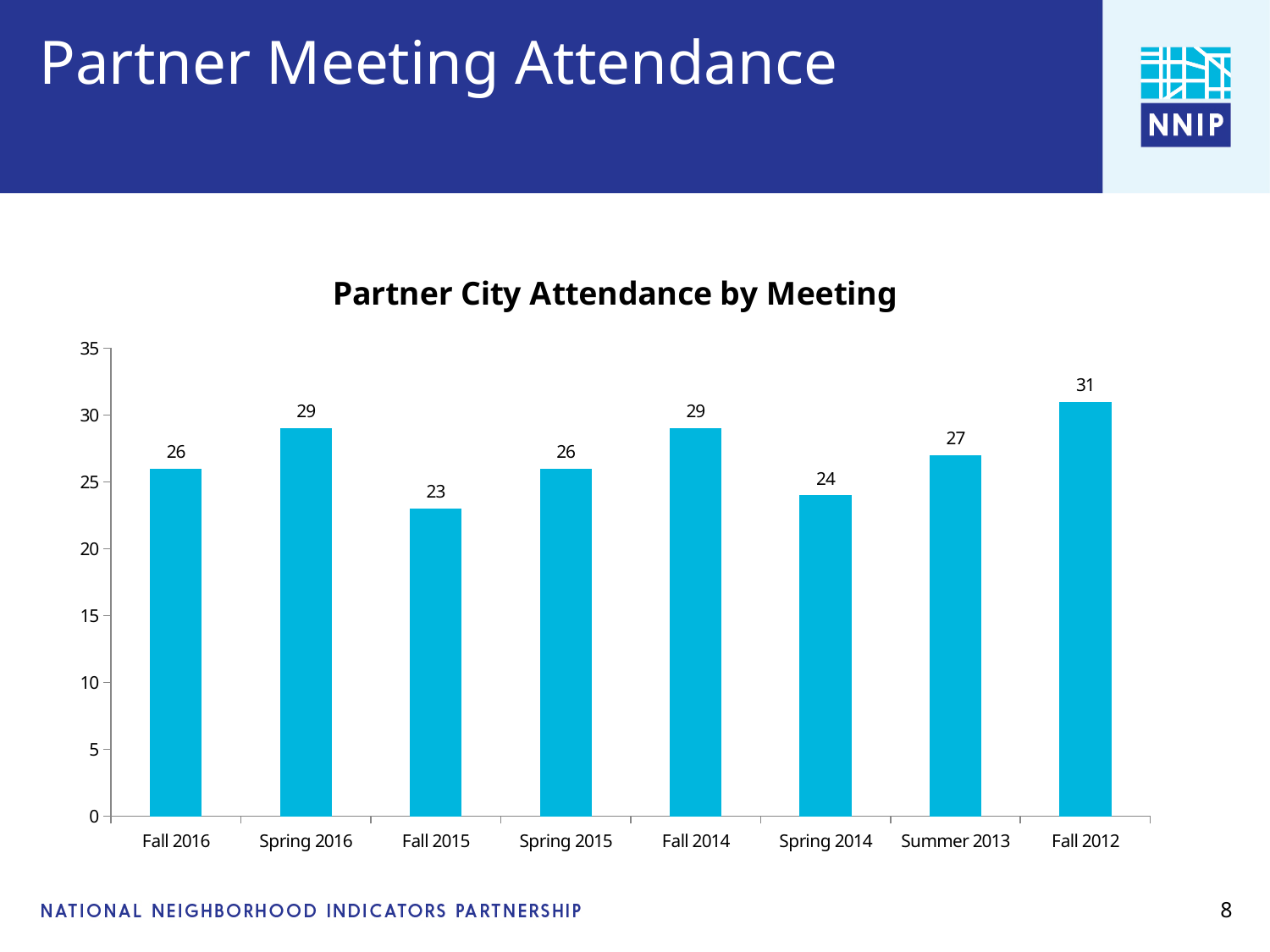
Which meeting has the lowest partner city attendance? Fall 2015 Which has higher attendance, Fall 2014 or Summer 2013? Fall 2014 What kind of chart is shown on the slide? Bar chart What is the partner city attendance for Fall 2016? 26 What is the difference in attendance between Spring 2016 and Spring 2014? 5 Which meeting has the highest partner city attendance? Fall 2012 What is the difference in attendance between Fall 2012 and Fall 2015? 8 What is the partner city attendance for Summer 2013? 27 Is the attendance for Spring 2014 greater or less than 25? less What is the partner city attendance for Fall 2015? 23 What is the title of the chart? Partner City Attendance by Meeting How many meetings are shown on the chart? 8